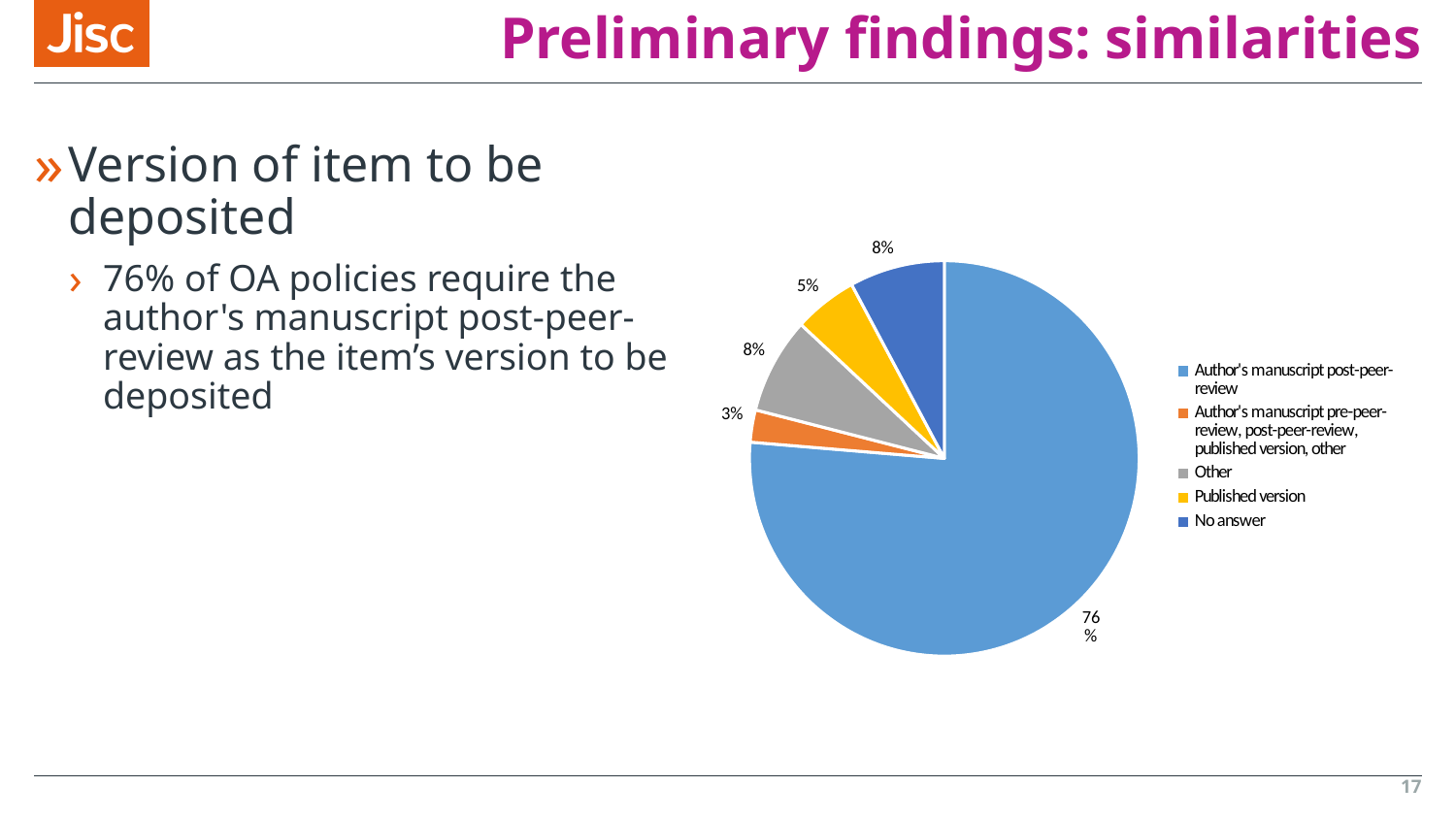
Which category has the smallest share of the pie? Author's manuscript pre-peer-review, post-peer-review, published version, other Which category has the largest share of the pie? Author's manuscript post-peer-review What percentage is shown for the "No answer" slice? 8% What percentage is shown for the "Author's manuscript pre-peer-review, post-peer-review, published version, other" slice? 3% What colour is the "Published version" slice? yellow Which is larger: the "Published version" slice or the "Other" slice? Other What is the difference in percentage points between the "Author's manuscript post-peer-review" slice and the "No answer" slice? 68 What type of chart is shown on the slide? pie chart What percentage is shown for the "Other" slice? 8% How many categories does the legend list? 5 What percentage is shown for the "Published version" slice? 5% What percentage of the pie is labelled for "Author's manuscript post-peer-review"? 76%